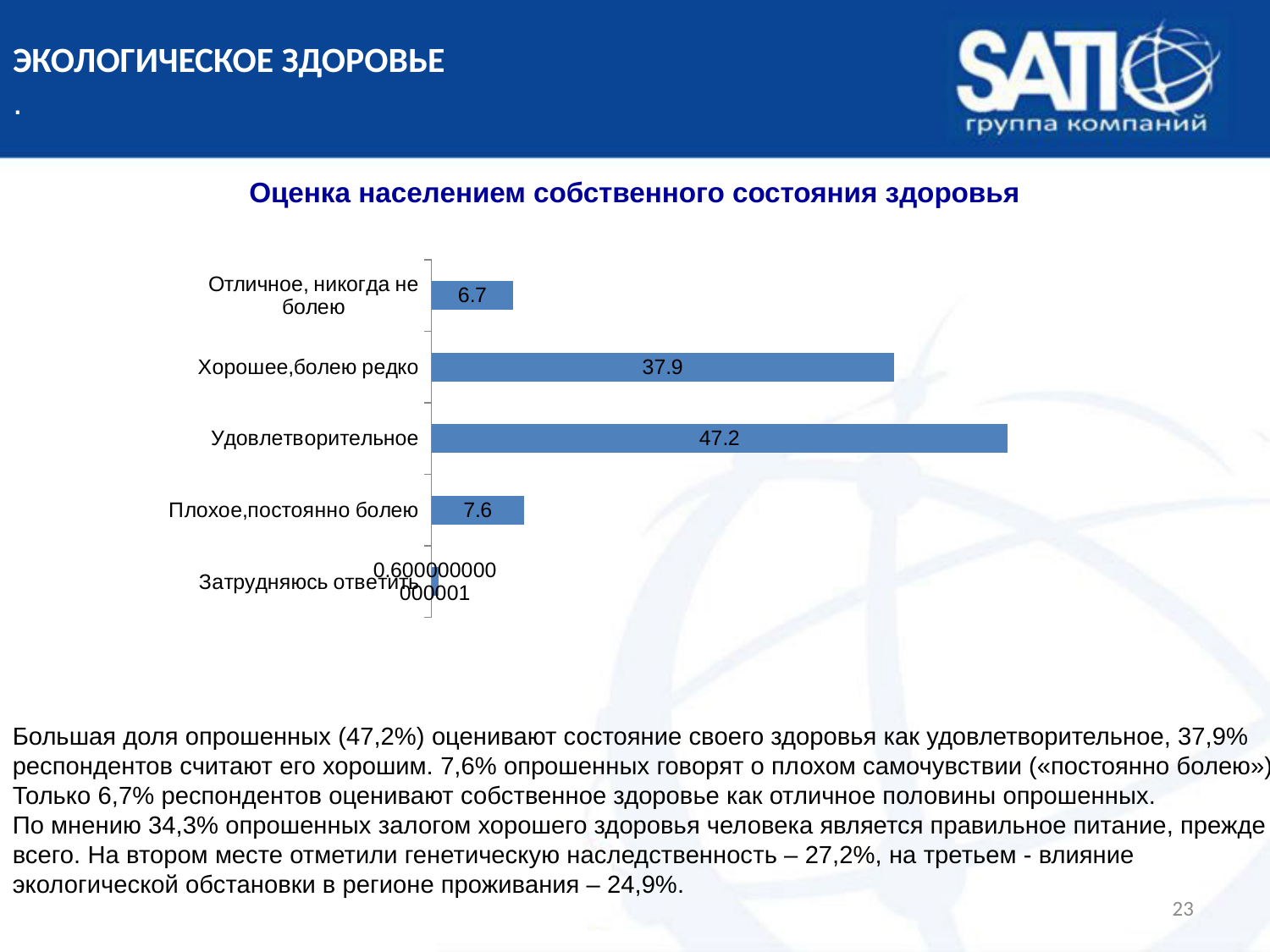
What value is shown for "Отличное, никогда не болею"? 6.7 What value is shown for "Хорошее,болею редко"? 37.9 What is the difference between the values for "Плохое,постоянно болею" and "Отличное, никогда не болею"? 0.9 Which category has the lowest value? Затрудняюсь ответить Which category has the highest value? Удовлетворительное Which is larger, the value for "Плохое,постоянно болею" or for "Отличное, никогда не болею"? Плохое,постоянно болею What value is shown for "Удовлетворительное"? 47.2 How many categories are shown in the chart? 5 What is the title of the chart? Оценка населением собственного состояния здоровья What is the difference between the values for "Удовлетворительное" and "Хорошее,болею редко"? 9.3 What type of chart is shown on the slide? Bar chart What value is shown for "Плохое,постоянно болею"? 7.6